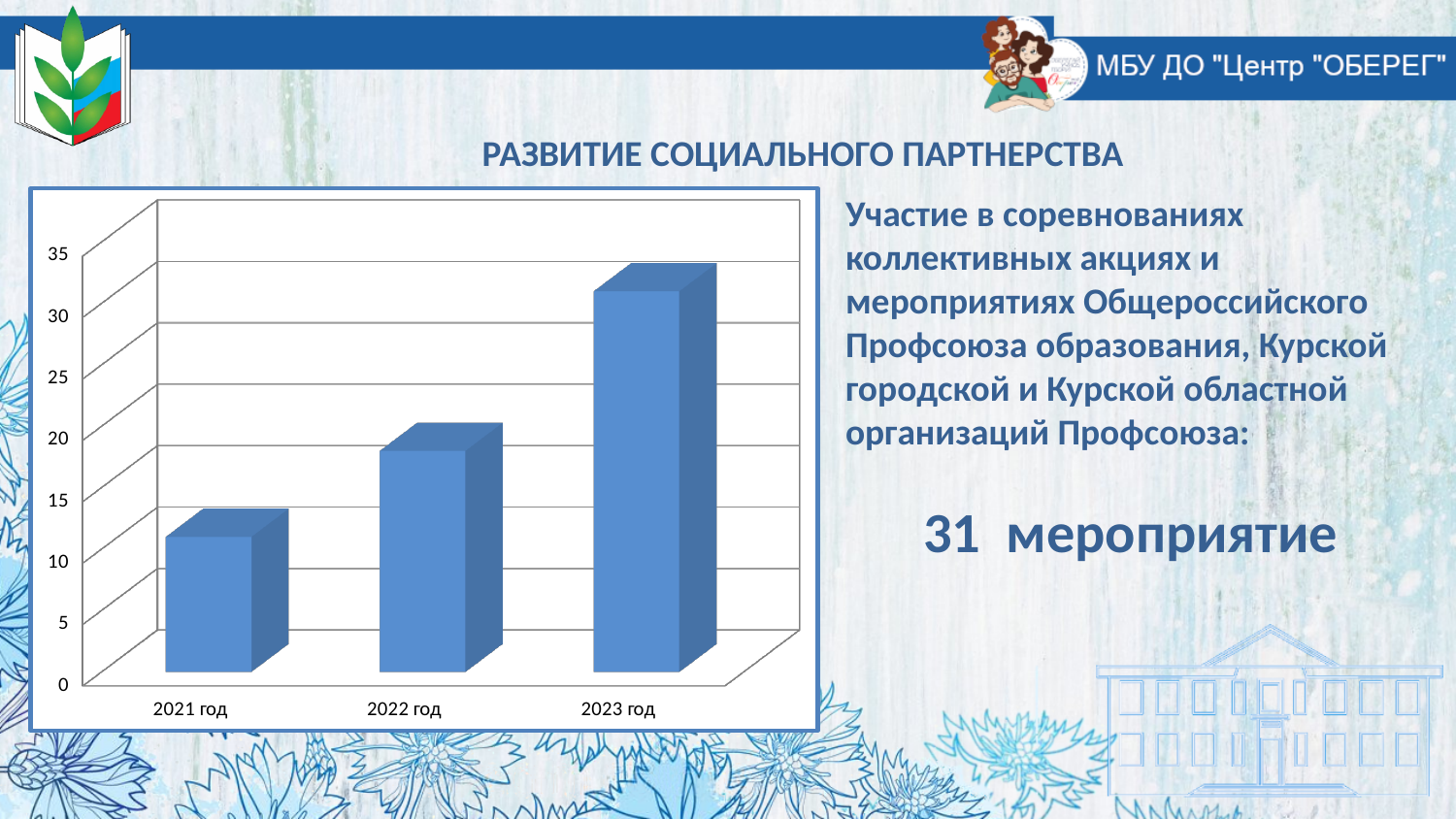
How many categories (years) are plotted in the chart? 3 Is the value for 2023 год greater or less than 25? greater Do the values rise or fall from 2021 год to 2023 год? rise Which year has the lowest bar in the chart? 2021 год Is the value for 2023 год greater or less than 35? less Which year has the highest bar in the chart? 2023 год Is the value for 2022 год greater or less than 15? greater What kind of chart is shown on the slide? bar chart Which is larger, the value for 2022 год or the value for 2021 год? 2022 год